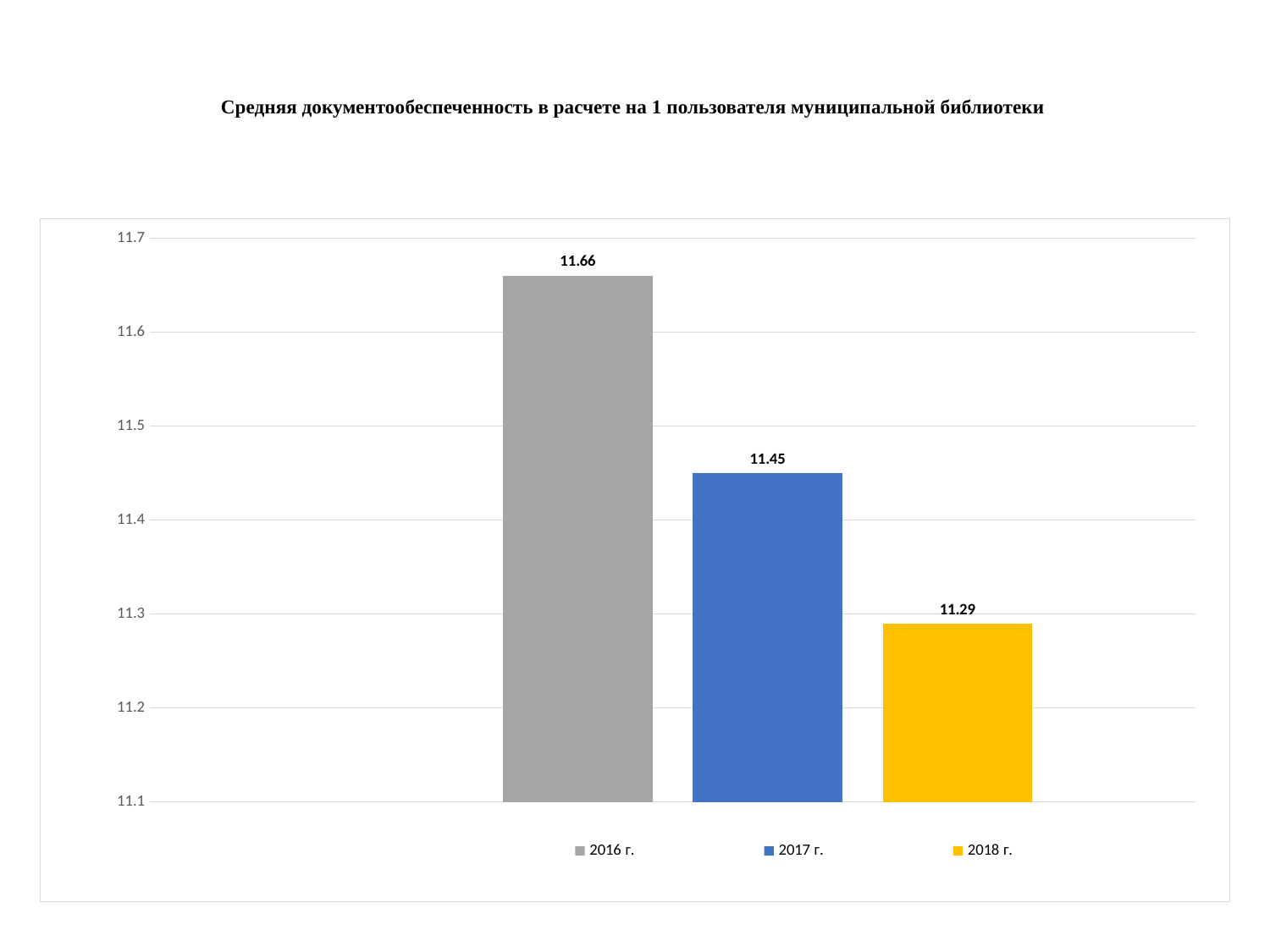
What is the difference between the values for 2017 г. and 2018 г.? 0.16 What is the difference between the values for 2016 г. and 2018 г.? 0.37 What is the value for 2016 г.? 11.66 Which year has the highest value? 2016 г. Is the value for 2017 г. greater or less than 11.5? less What kind of chart is shown on the slide? bar chart How many series does the legend list? 3 Which is larger, the value for 2016 г. or the value for 2017 г.? 2016 г. Which year has the lowest value? 2018 г. Do the values rise or fall from 2016 г. to 2018 г.? fall What is the value for 2017 г.? 11.45 What is the value for 2018 г.? 11.29